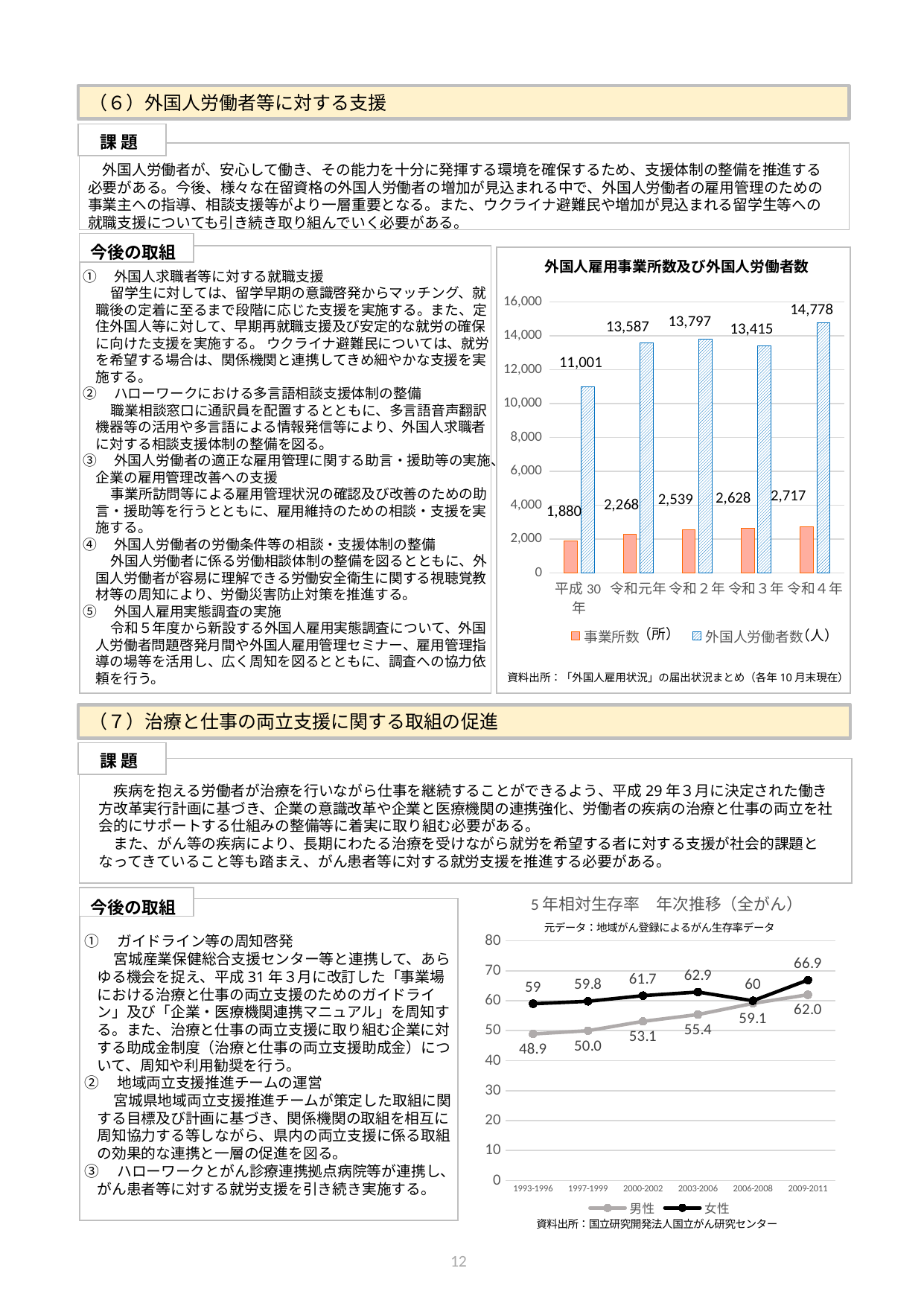
In the chart titled 外国人雇用事業所数及び外国人労働者数, what is the value of 事業所数（所） for 平成30年? 1,880 In the chart titled 5年相対生存率 年次推移（全がん）, what is the value for 女性 in 2006-2008? 60 In the chart titled 外国人雇用事業所数及び外国人労働者数, what is the difference in 事業所数（所） between 令和４年 and 令和３年? 89 In the chart titled 外国人雇用事業所数及び外国人労働者数, which is larger: 外国人労働者数(人) for 令和２年 or for 令和３年? 令和２年 In the chart titled 外国人雇用事業所数及び外国人労働者数, how many series does the legend list? 2 In the chart titled 5年相対生存率 年次推移（全がん）, what is the difference between 女性 and 男性 in 2009-2011? 4.9 What kind of chart is the chart titled 外国人雇用事業所数及び外国人労働者数? bar chart In the chart titled 5年相対生存率 年次推移（全がん）, what is the value for 男性 in 2009-2011? 62.0 In the chart titled 5年相対生存率 年次推移（全がん）, how many time periods are shown on the x axis? 6 In the chart titled 外国人雇用事業所数及び外国人労働者数, which year has the lowest 外国人労働者数(人)? 平成30年 In the chart titled 5年相対生存率 年次推移（全がん）, does the 男性 line rise or fall from 1993-1996 to 2009-2011? rise In the chart titled 外国人雇用事業所数及び外国人労働者数, what is the value of 外国人労働者数(人) for 令和４年? 14,778